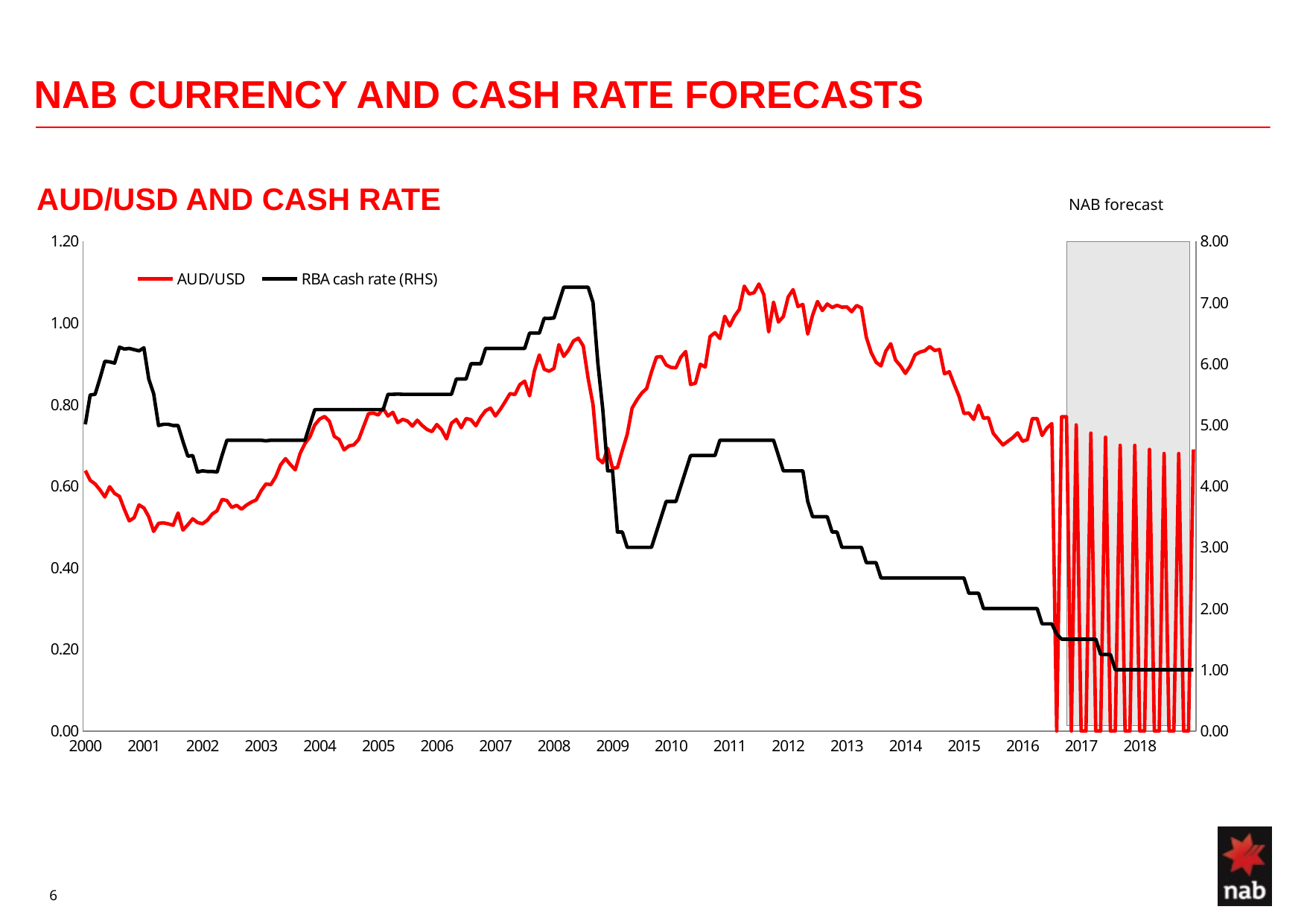
Is the AUD/USD value in 2001 greater or less than 0.60? less Does the RBA cash rate rise or fall between 2011 and 2016? fall In which year does the RBA cash rate reach its highest level? 2008 Does the AUD/USD rate rise or fall between 2001 and 2008? rise What is the title of the chart? AUD/USD AND CASH RATE What kind of chart is shown on the slide? line chart How many series does the legend list? 2 Is the peak AUD/USD value in 2011 greater or less than 1.00? greater Which is larger, the AUD/USD value in 2001 or in 2011? 2011 What does the shaded area at the right of the chart represent? NAB forecast Is the RBA cash rate in 2018 greater or less than 2.00? less